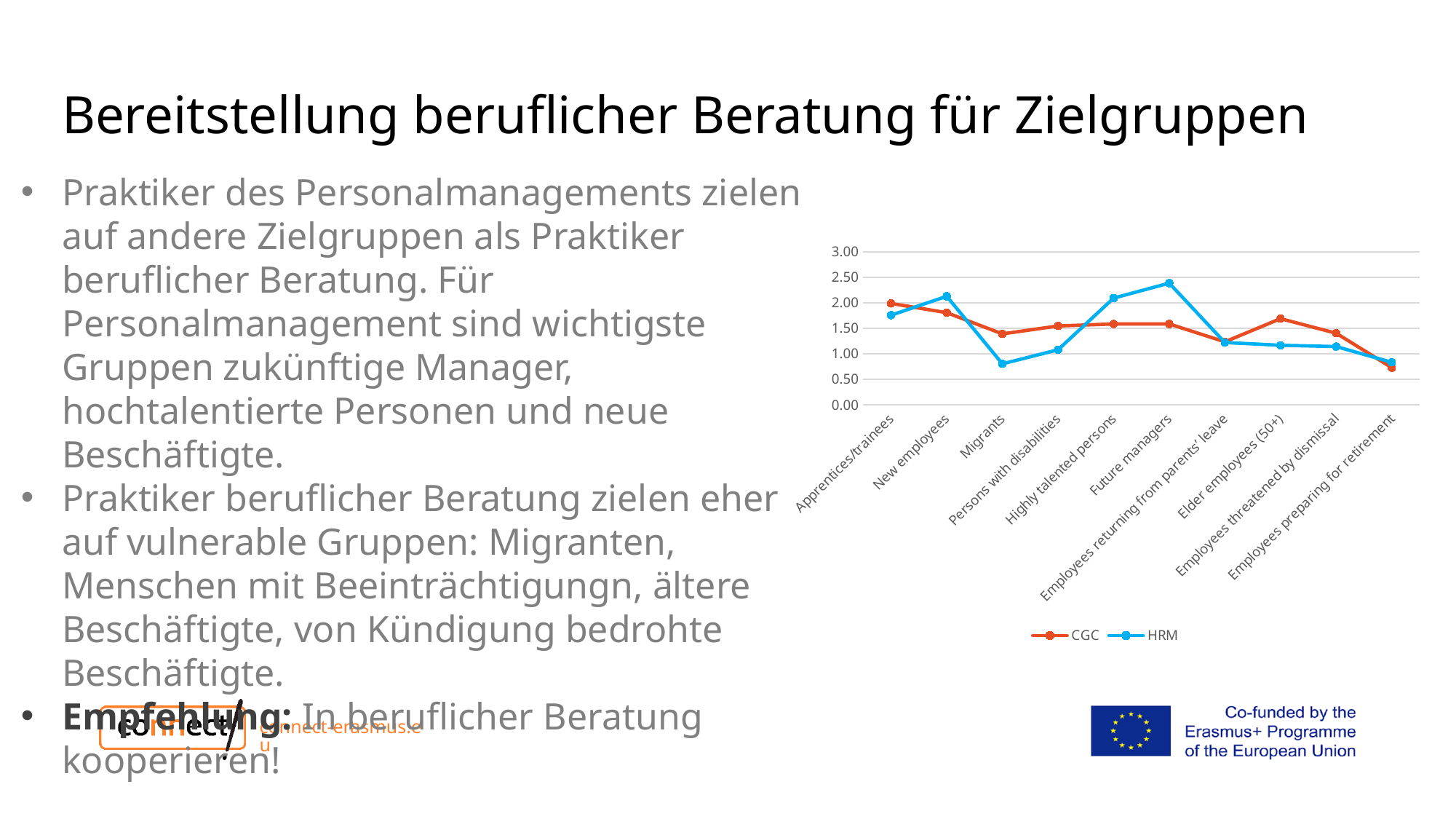
Which category has the highest CGC value? Apprentices/trainees For Migrants, which series has the larger value, CGC or HRM? CGC How many categories are shown on the x axis of the chart? 10 For Future managers, which series has the larger value, CGC or HRM? HRM Is the CGC value for Elder employees (50+) greater or less than 1.50? greater How many series does the chart legend list? 2 Which category has the highest HRM value? Future managers What kind of chart is shown on the slide? line chart Which series is drawn in blue in the chart? HRM Which category has the lowest CGC value? Employees preparing for retirement Is the HRM value for Future managers greater or less than 2.00? greater Is the HRM value for Migrants greater or less than 1.00? less